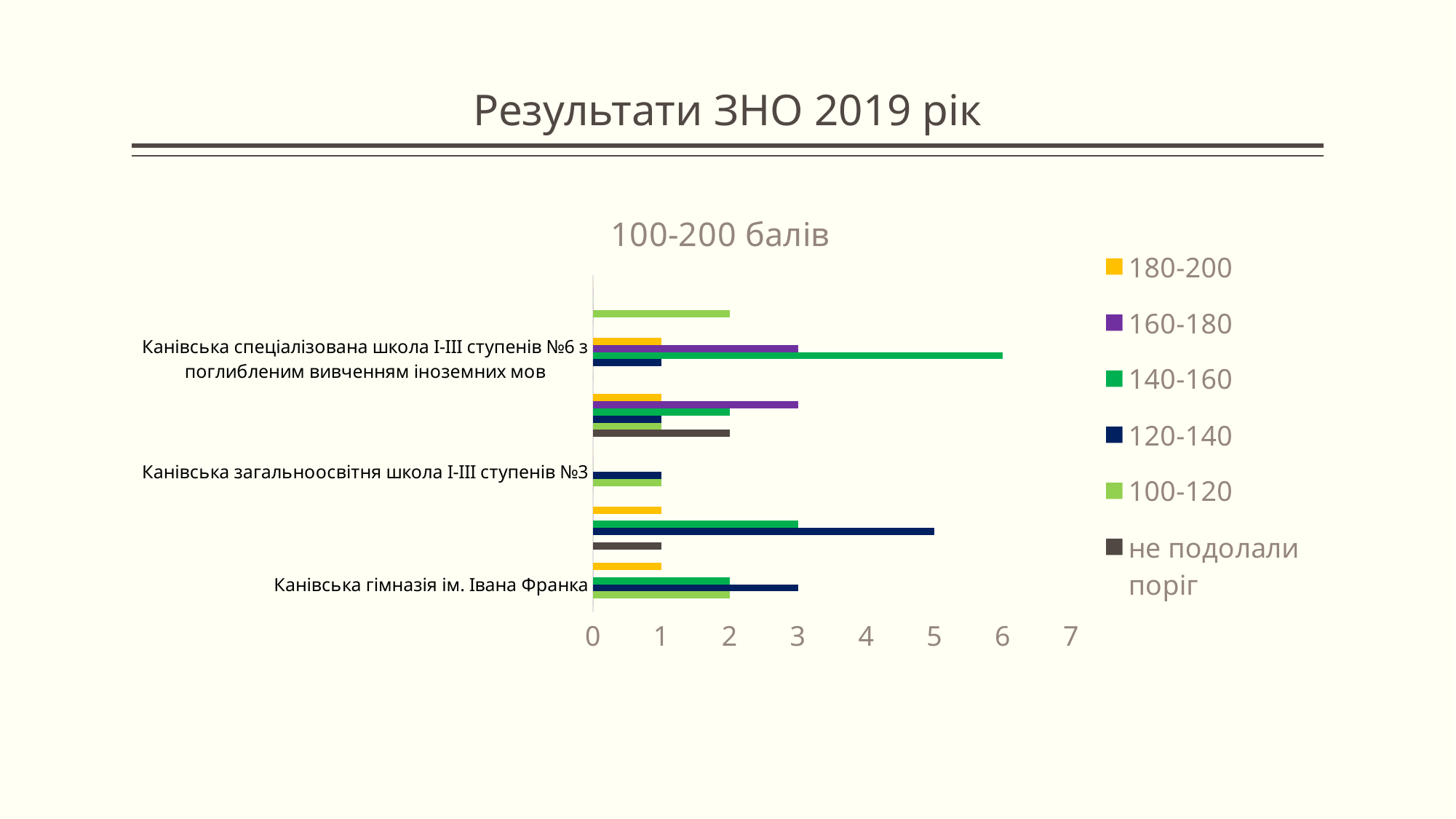
What is the value of the 140-160 series for Канівська спеціалізована школа I-III ступенів №6 з поглибленим вивченням іноземних мов? 6 What is the value of the 180-200 series for Канівська гімназія ім. Івана Франка? 1 What kind of chart is shown on the slide? bar chart Which series has the highest value for Канівська спеціалізована школа I-III ступенів №6 з поглибленим вивченням іноземних мов? 140-160 Is the 140-160 value for Канівська спеціалізована школа I-III ступенів №6 greater or less than 5? greater What is the title of the chart? 100-200 балів What is the difference between the 140-160 value for Канівська спеціалізована школа I-III ступенів №6 and the 140-160 value for Канівська гімназія ім. Івана Франка? 4 What is the value of the 120-140 series for Канівська гімназія ім. Івана Франка? 3 How many series does the legend list? 6 Which legend entry is shown in yellow? 180-200 Which is larger: the 140-160 value for Канівська спеціалізована школа I-III ступенів №6 or the 140-160 value for Канівська гімназія ім. Івана Франка? Канівська спеціалізована школа I-III ступенів №6 What is the value of the 160-180 series for Канівська спеціалізована школа I-III ступенів №6 з поглибленим вивченням іноземних мов? 3